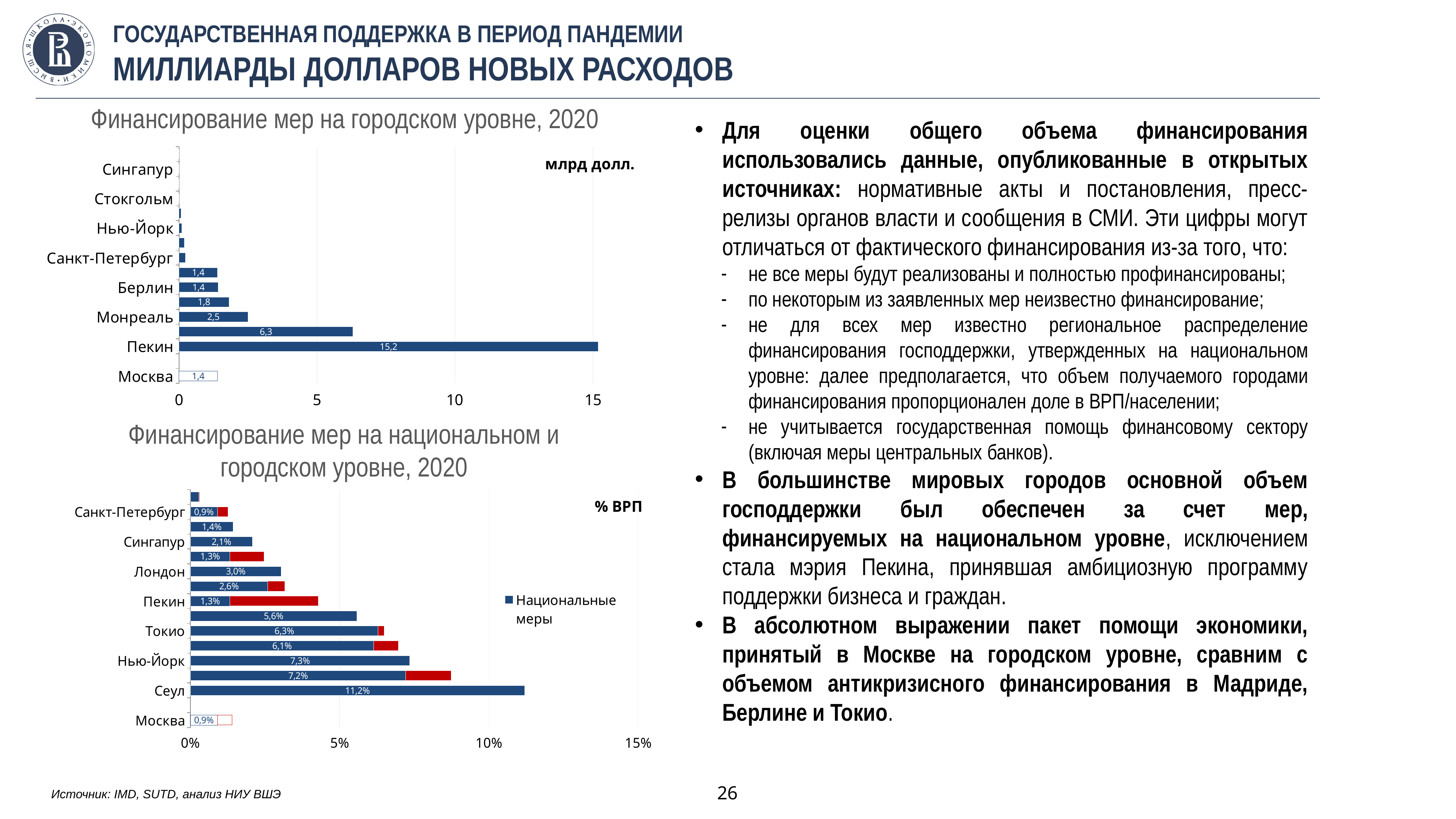
In the top chart 'Финансирование мер на городском уровне, 2020', which city has the highest value? Пекин What kind of chart is the top chart, 'Финансирование мер на городском уровне, 2020'? bar chart In the bottom chart 'Финансирование мер на национальном и городском уровне, 2020', which city has the highest labelled value? Сеул In the top chart 'Финансирование мер на городском уровне, 2020', what unit is shown in the chart? млрд долл. In the top chart 'Финансирование мер на городском уровне, 2020', what is the difference between the values for Пекин and Москва? 13,8 In the bottom chart 'Финансирование мер на национальном и городском уровне, 2020', what series name is shown in the legend? Национальные меры In the bottom chart 'Финансирование мер на национальном и городском уровне, 2020', what is the labelled value for Москва? 0,9% In the bottom chart 'Финансирование мер на национальном и городском уровне, 2020', what is the labelled value for Сеул? 11,2% In the top chart 'Финансирование мер на городском уровне, 2020', which is larger, the value for Монреаль or for Берлин? Монреаль In the top chart 'Финансирование мер на городском уровне, 2020', what is the value for Москва? 1,4 In the top chart 'Финансирование мер на городском уровне, 2020', is the value for Пекин greater or less than 10? greater In the top chart 'Финансирование мер на городском уровне, 2020', what is the value for Пекин? 15,2